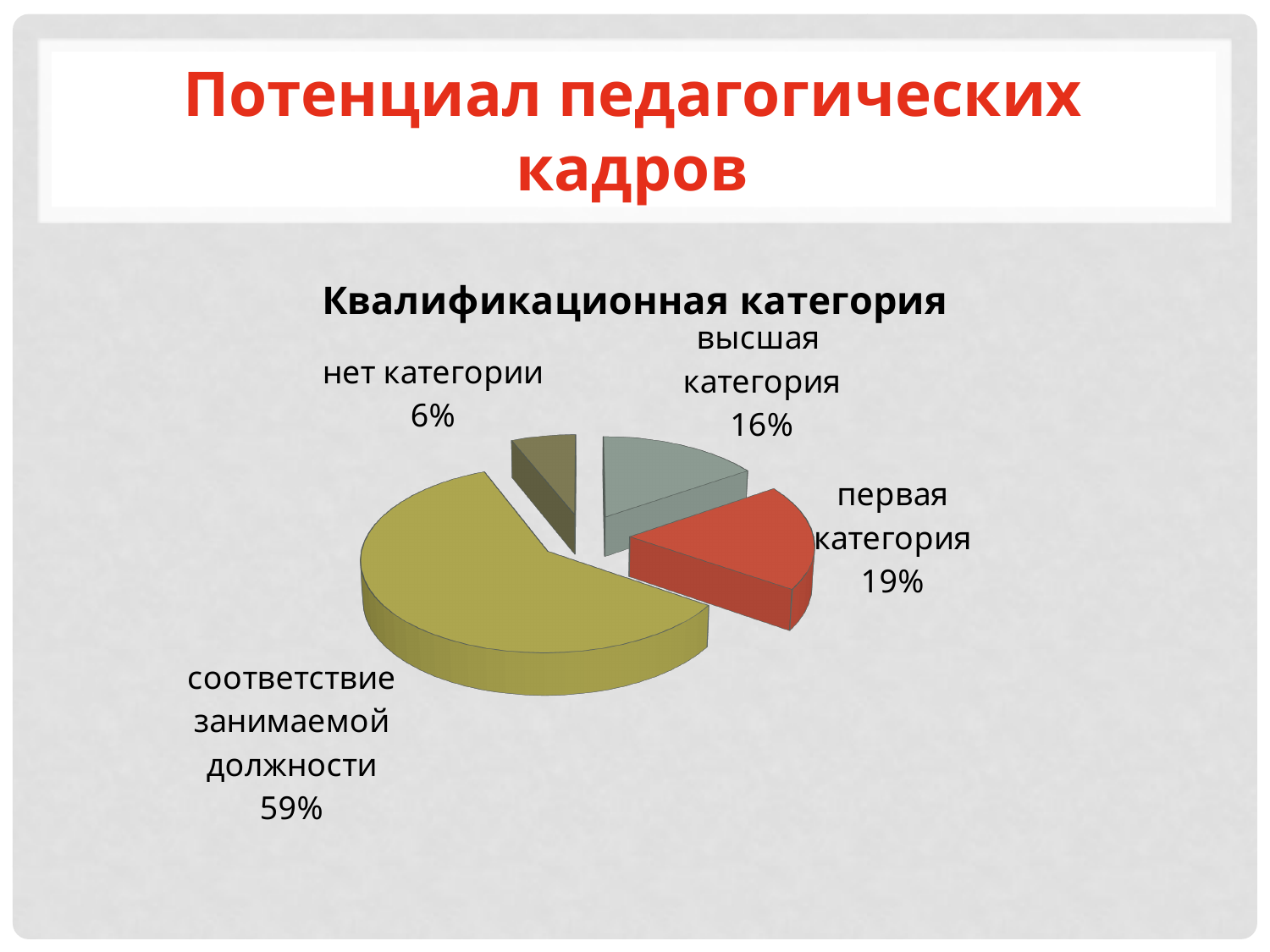
What share of the pie is labelled 'первая категория'? 19% What type of chart is shown on the slide? Pie chart What is the title of the chart? Квалификационная категория What colour is the slice for 'первая категория'? Red How many slices does the pie chart have? 4 Which is larger, the share for 'первая категория' or the share for 'нет категории'? первая категория What share of the pie is labelled 'нет категории'? 6% Which category has the largest slice of the pie? соответствие занимаемой должности What share of the pie is labelled 'высшая категория'? 16% What is the difference in percentage points between 'первая категория' and 'высшая категория'? 3% Which category has the smallest slice of the pie? нет категории